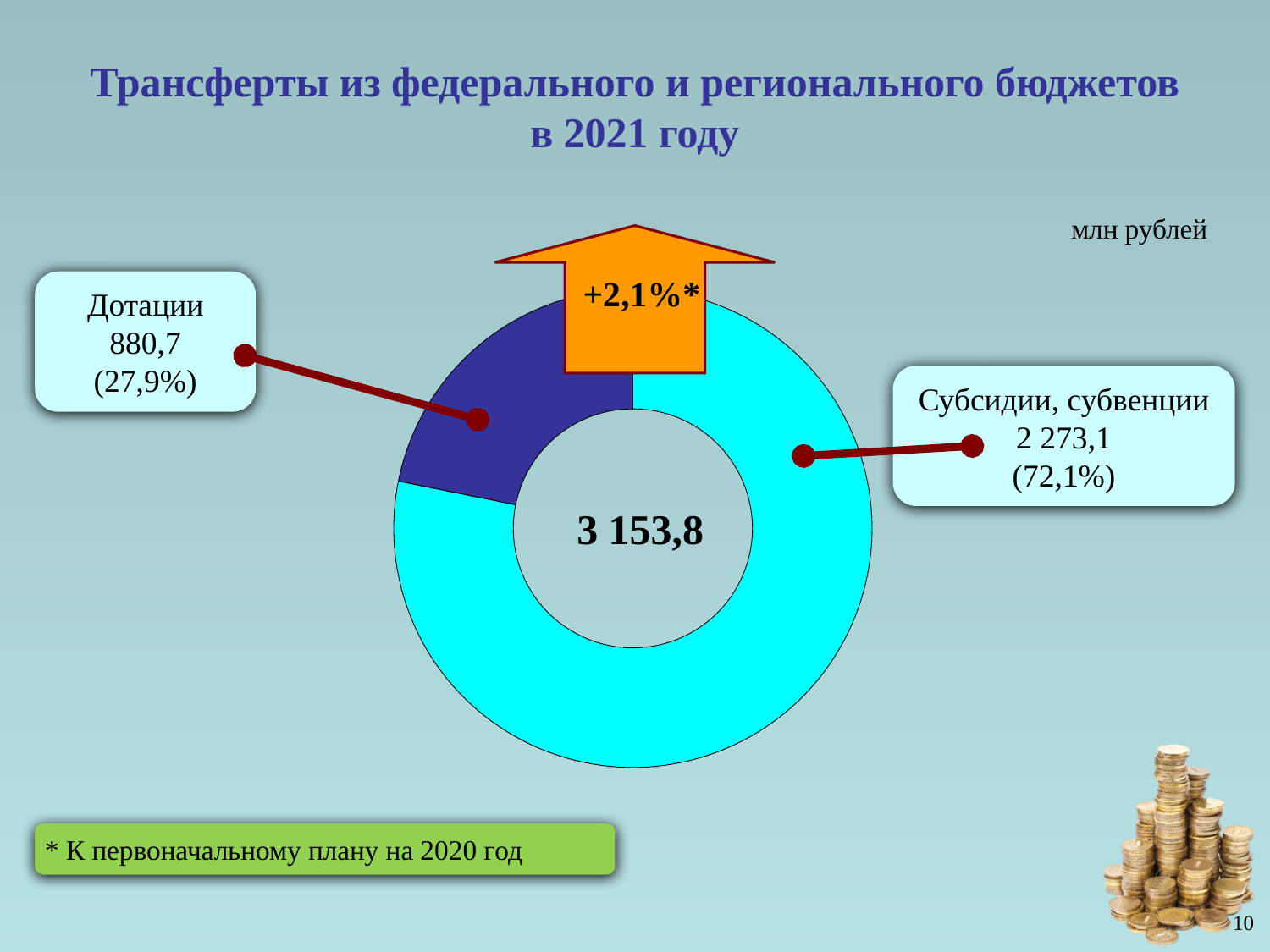
What is the total shown in the centre of the chart? 3 153,8 What share of the chart do Дотации make up? 27,9% What kind of chart is shown on the slide? Pie (donut) chart What is the value for Субсидии, субвенции? 2 273,1 What unit of measurement is indicated for the chart values? млн рублей Which category is the largest? Субсидии, субвенции What is the value for Дотации? 880,7 What share of the chart do Субсидии, субвенции make up? 72,1% What is the difference between Субсидии, субвенции and Дотации? 1 392,4 How many categories does the chart show? 2 Which is larger, Дотации or Субсидии, субвенции? Субсидии, субвенции Which category is the smallest? Дотации